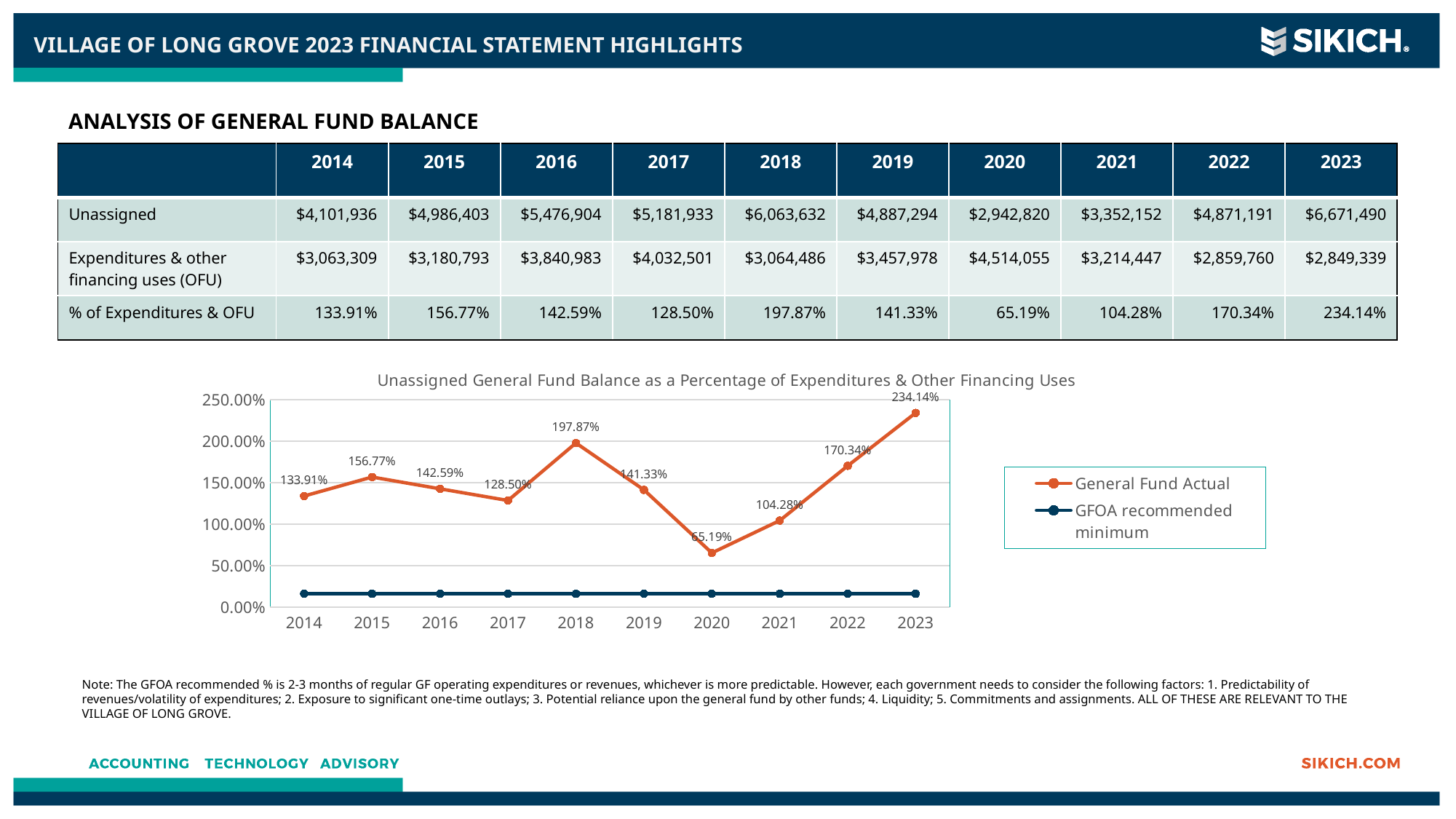
What is the difference between the General Fund Actual values for 2023 and 2022? 63.80% Is the GFOA recommended minimum value for 2020 greater or less than 50.00%? less What is the General Fund Actual value for 2020? 65.19% What is the General Fund Actual value for 2018? 197.87% How many years are plotted on the x axis of the chart? 10 What kind of chart is shown on the slide? line chart What is the General Fund Actual value for 2014? 133.91% In which year is the General Fund Actual value lowest? 2020 Does the General Fund Actual line rise or fall from 2020 to 2023? rise In which year is the General Fund Actual value highest? 2023 How many series does the chart legend list? 2 Which year has the larger General Fund Actual value, 2015 or 2016? 2015